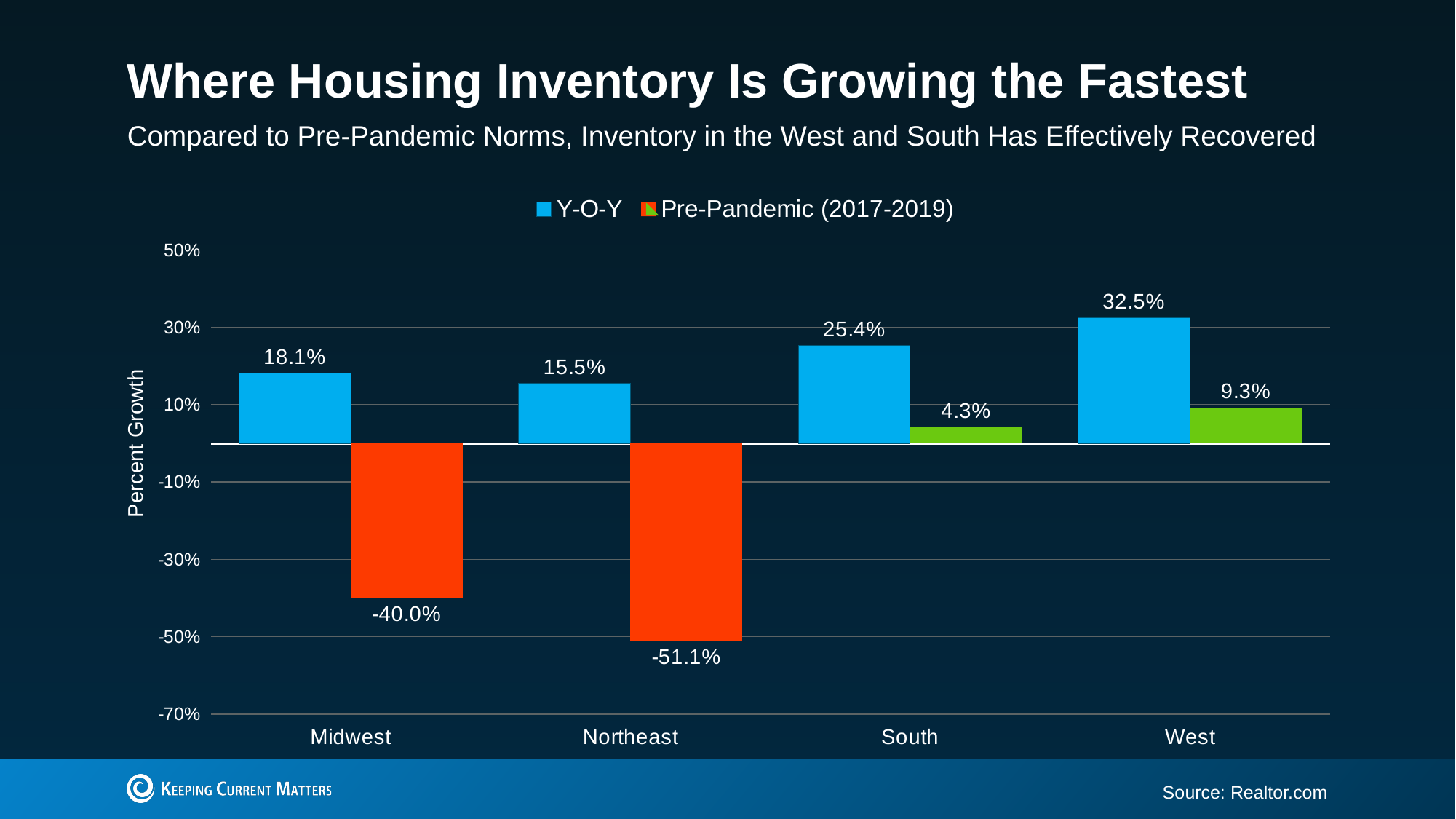
What kind of chart is shown on the slide? Bar chart What is the Pre-Pandemic (2017-2019) value for the Northeast? -51.1% What is the source cited for the chart? Realtor.com What is the Y-O-Y value for the West? 32.5% Which region has the highest Y-O-Y value? West How many series does the legend list? 2 What is the label of the vertical axis? Percent Growth Which region has the lowest Pre-Pandemic (2017-2019) value? Northeast Which is larger, the Y-O-Y value for the Midwest or the Y-O-Y value for the Northeast? Midwest What is the difference between the Y-O-Y values for the South and the Northeast? 9.9% How many regions are shown on the x axis? 4 What is the Pre-Pandemic (2017-2019) value for the South? 4.3%